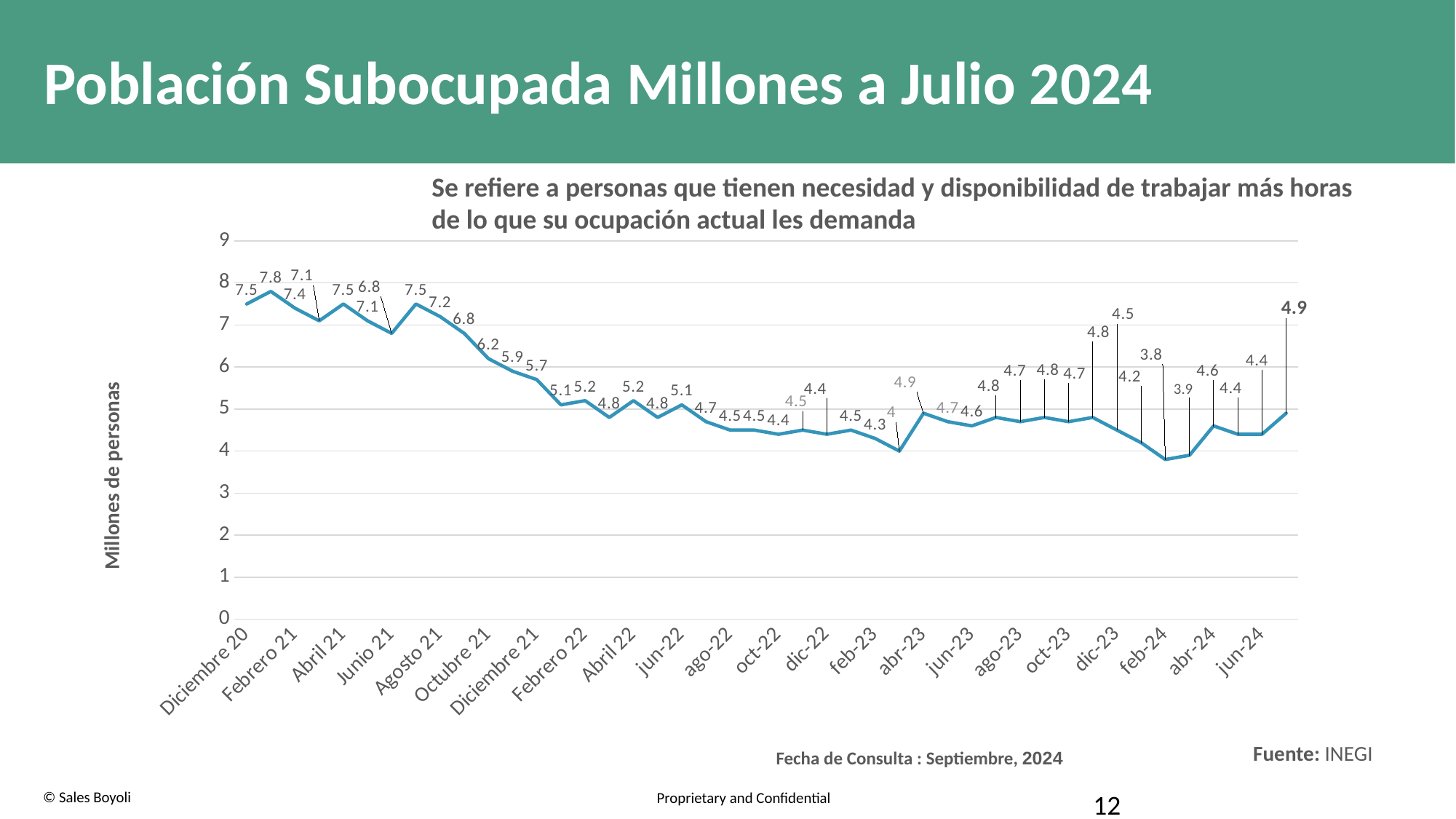
What is the title of the vertical axis? Millones de personas What is the value for Octubre 21? 6.2 What is the value for abr-23? 4.9 What kind of chart is shown on the slide? line chart What is the value for feb-24? 3.8 What is the highest value shown on the line? 7.8 What is the value for Diciembre 20? 7.5 What is the difference between the value for Diciembre 20 and the value for feb-24? 3.7 What is the lowest value shown on the line? 3.8 Overall, do the values rise or fall from Diciembre 20 to the end of the series? fall Is the value for Diciembre 21 greater or less than 6? less Which is larger, the value for Abril 21 or the value for abr-24? Abril 21